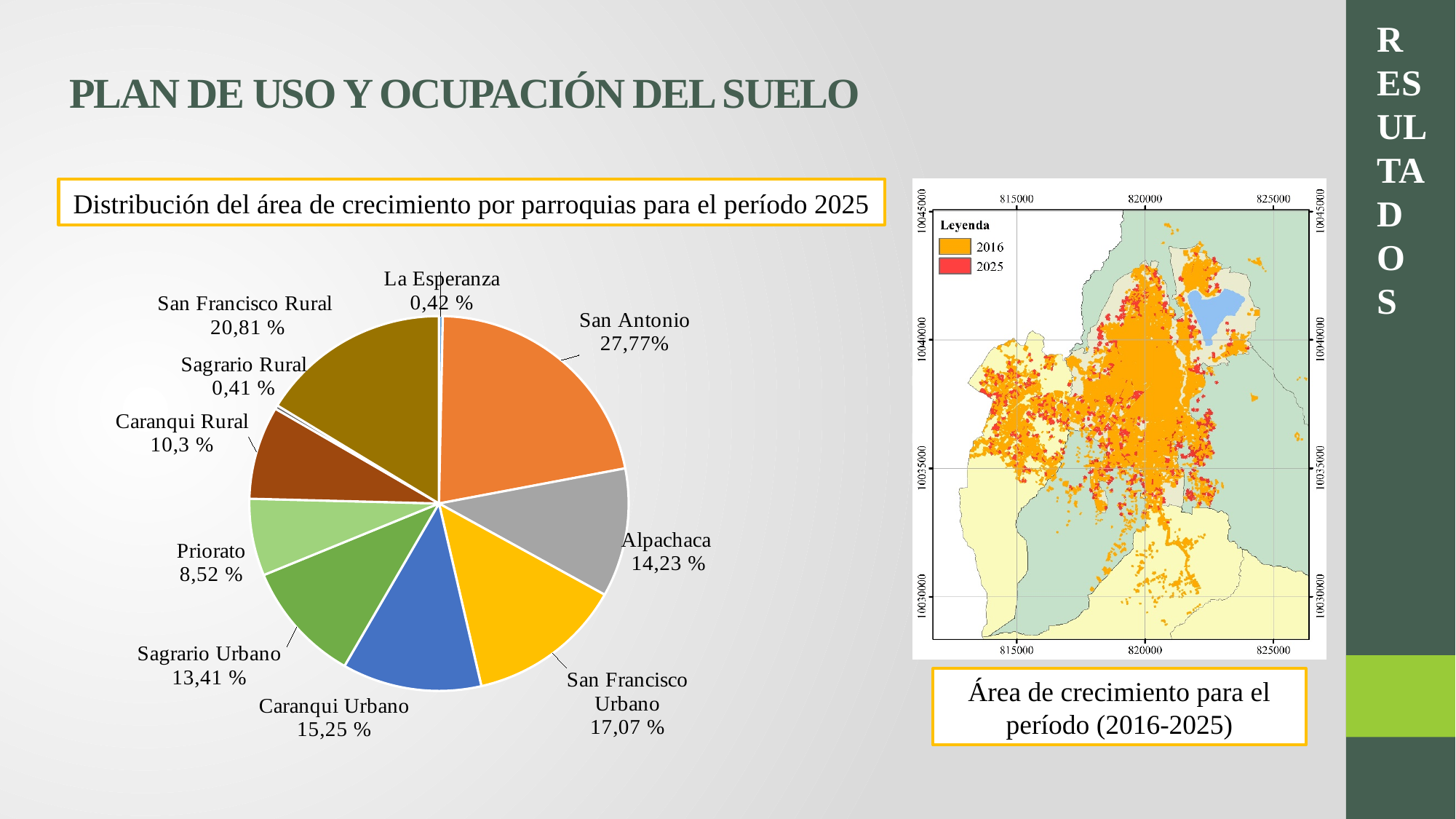
What is the difference between the percentages for San Antonio and Alpachaca? 13,54 % What type of chart is used to show the distribution of growth area by parish for 2025? pie chart What is the value for San Francisco Rural in the pie chart? 20,81 % Which has a larger share, Caranqui Rural or Priorato? Caranqui Rural Which has a larger share, San Francisco Urbano or Sagrario Urbano? San Francisco Urbano Which parish has the largest share of the growth area in the pie chart? San Antonio What percentage does the pie chart show for Caranqui Urbano? 15,25 % How many parishes (slices) are shown in the pie chart? 10 What percentage of the growth area is attributed to San Antonio? 27,77% What is the value shown for Alpachaca in the pie chart? 14,23 % What is the title of the pie chart on the slide? Distribución del área de crecimiento por parroquias para el período 2025 What percentage is shown for Priorato? 8,52 %